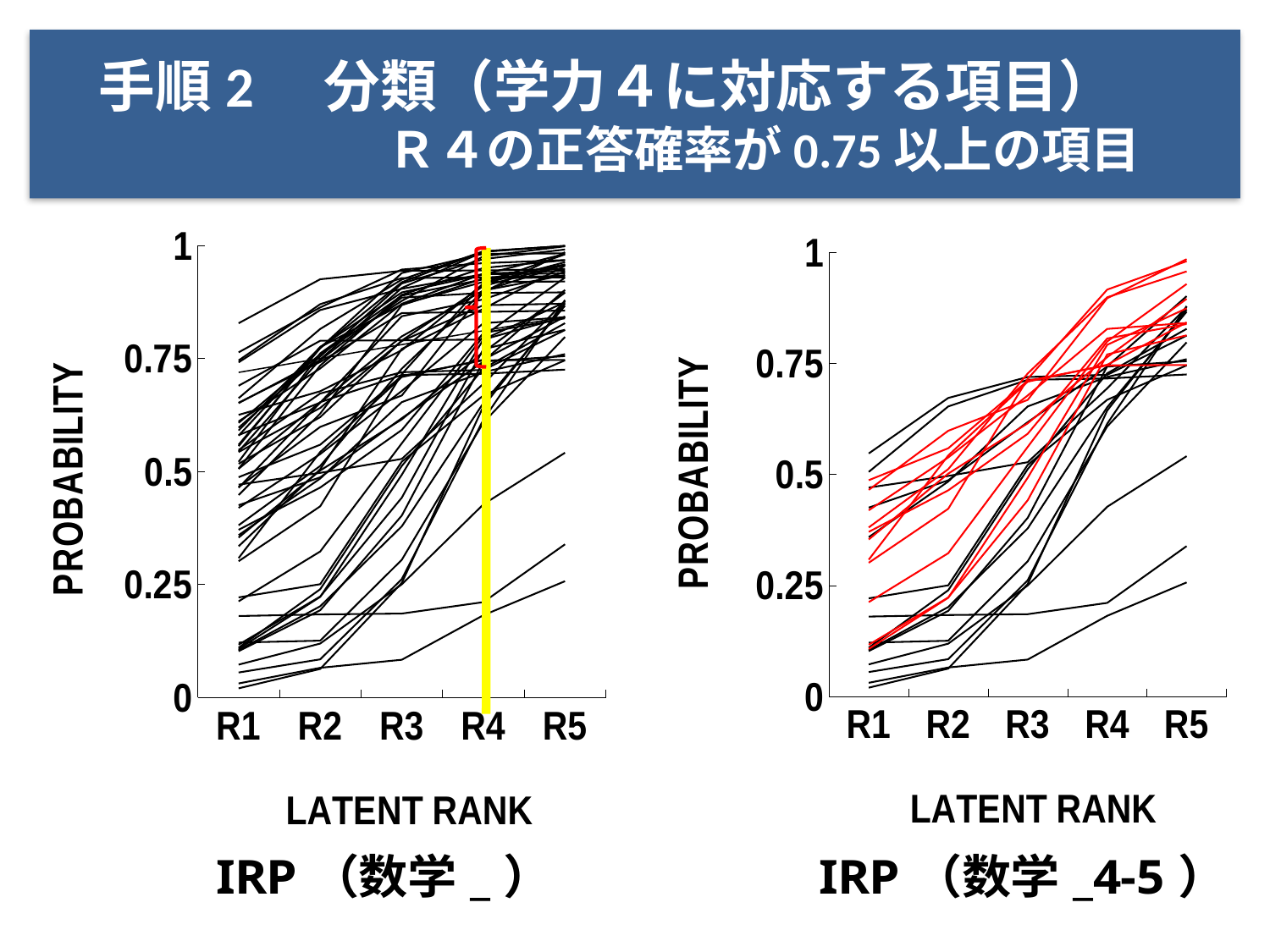
What kind of chart is the left chart, IRP (数学_)? line chart In the right chart, IRP (数学_4-5), do the red lines generally rise or fall from R1 to R5? rise How many latent rank categories are shown on the x axis of the right chart, IRP (数学_4-5)? 5 What is the first category on the x axis of the right chart, IRP (数学_4-5)? R1 What is the label of the y axis on the left chart, IRP (数学_)? PROBABILITY What is the label of the x axis on the right chart, IRP (数学_4-5)? LATENT RANK How many latent rank categories are shown on the x axis of the left chart, IRP (数学_)? 5 In the left chart, IRP (数学_), do the lines generally rise or fall from R1 to R5? rise In the right chart, IRP (数学_4-5), are the red lines at R1 greater or less than 0.75? less What kind of chart is the right chart, IRP (数学_4-5)? line chart What is the highest tick value shown on the y axis of the left chart, IRP (数学_)? 1 What is the last category on the x axis of the left chart, IRP (数学_)? R5